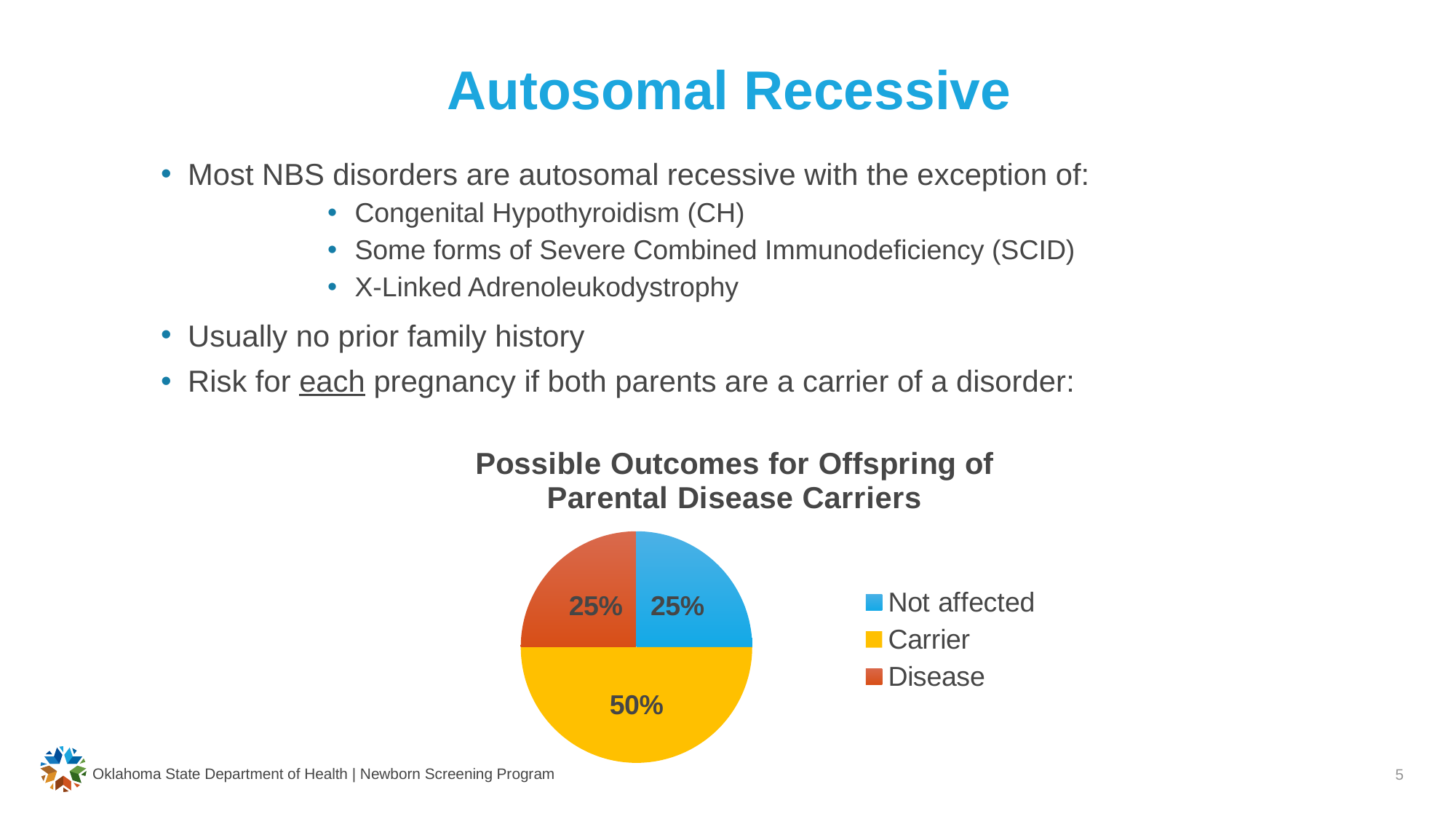
Which is larger, the Carrier slice or the Not affected slice? Carrier How many entries does the legend list? 3 What kind of chart is shown on the slide? pie chart Which category has the largest slice of the pie? Carrier What is the combined share of the Not affected and Disease slices? 50% What share of the pie is labelled Not affected? 25% What share of the pie is labelled Disease? 25% What is the title of the chart? Possible Outcomes for Offspring of Parental Disease Carriers What is the difference between the Carrier share and the Disease share? 25% What colour is the Carrier slice? yellow How many slices does the pie chart have? 3 What share of the pie is labelled Carrier? 50%